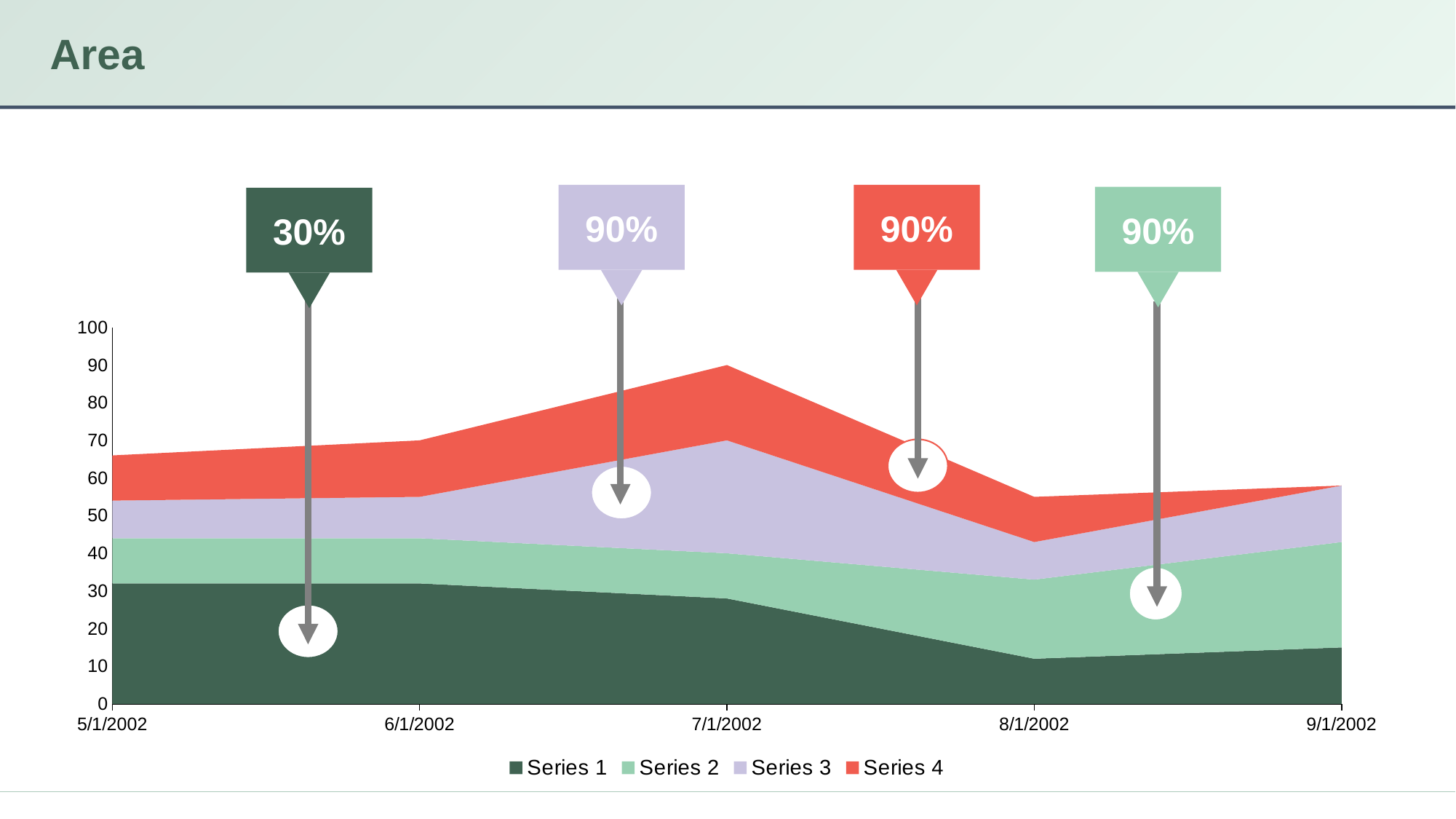
Is the top of the stacked area at 8/1/2002 greater or less than 60? less Is the value for Series 1 at 8/1/2002 greater or less than 20? less Is the top of the stacked area at 7/1/2002 greater or less than 80? greater At which date is the Series 1 value lowest? 8/1/2002 What kind of chart is shown on the slide? area chart At which date does the stacked area reach its highest total? 7/1/2002 How many series does the legend list? 4 Does the Series 1 value rise or fall from 5/1/2002 to 8/1/2002? fall How many dates are labelled on the x axis? 5 Which series is drawn at the bottom of the stacked area? Series 1 What is the title of the slide? Area